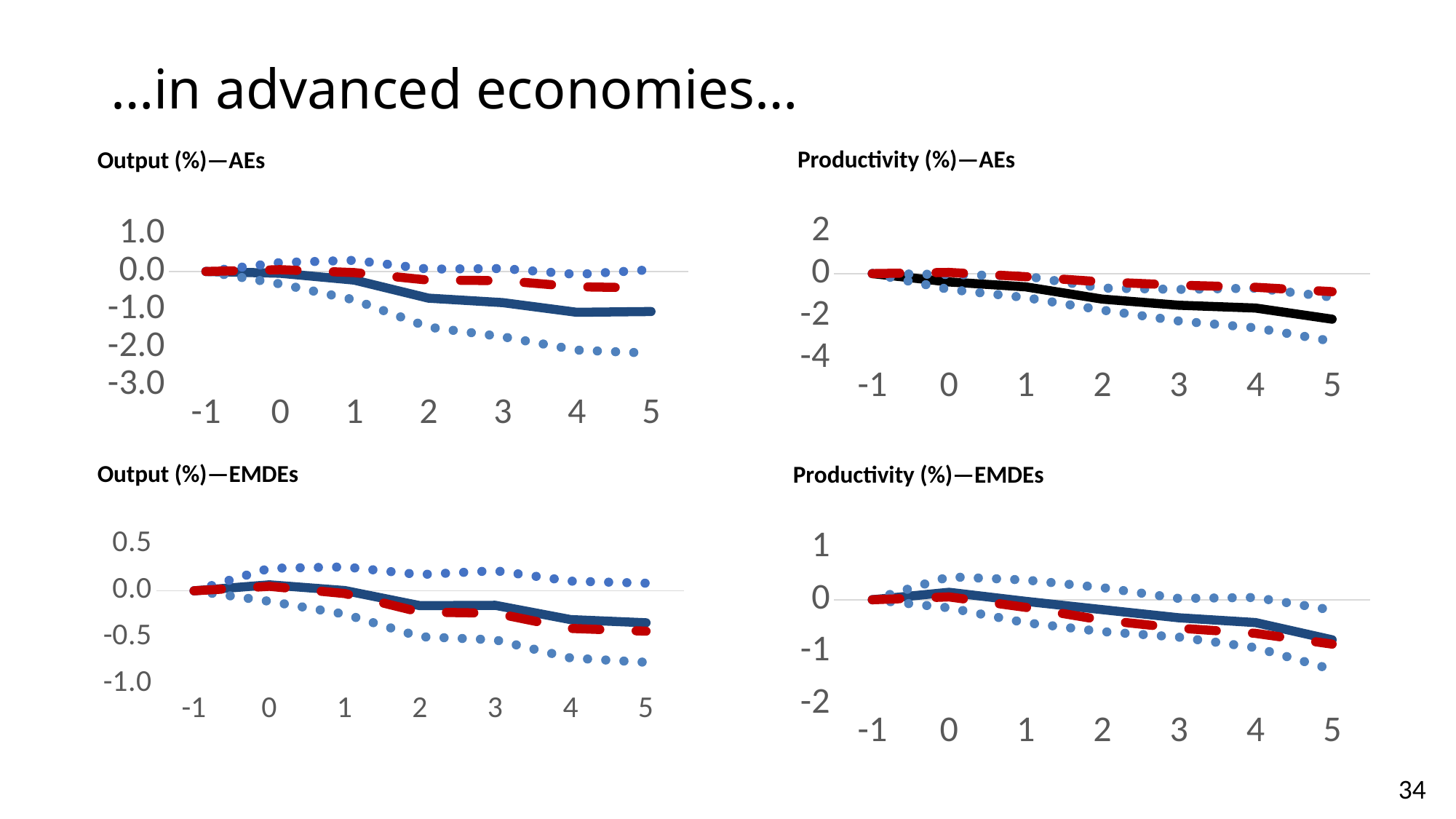
In the Output (%)—AEs chart, how many x-axis points are plotted along the solid line? 7 In the Output (%)—EMDEs chart, is the value of the solid line at x = 5 greater or less than -0.5? greater In the Productivity (%)—AEs chart, is the value of the solid line at x = 5 greater or less than 0? less In the Output (%)—EMDEs chart, is the solid line higher at x = 0 or at x = 5? x = 0 What kind of chart is the Output (%)—AEs chart? line chart In the Output (%)—EMDEs chart, does the solid line rise or fall overall from x = 0 to x = 5? fall How many charts are shown on the slide? 4 What is the title of the chart in the top-right position? Productivity (%)—AEs In the Output (%)—AEs chart, is the value of the solid line at x = 5 greater or less than -2.0? greater In the Productivity (%)—AEs chart, does the solid line rise or fall as the x axis goes from -1 to 5? fall